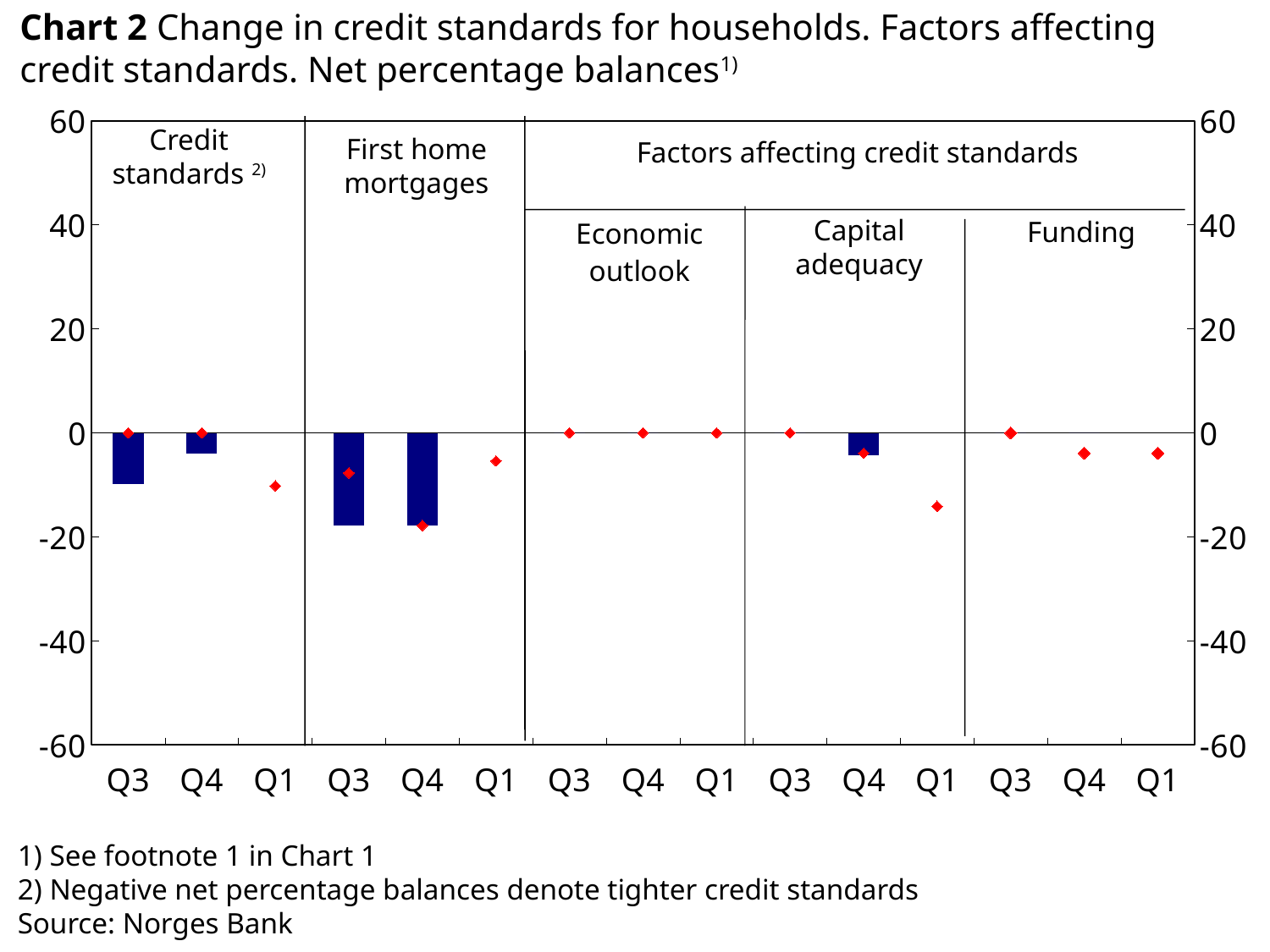
Do the values for Economic outlook rise, fall or stay flat from Q3 to Q1? stay flat What kind of chart is shown on the slide? bar chart with point markers Is the Q1 value for Funding greater or less than -20? greater What is the source given for the chart? Norges Bank Is the Q1 value for Capital adequacy greater or less than -10? less Is the value for Credit standards in Q4 greater or less than -20? greater Which is lower, the Q3 value for Credit standards or the Q3 value for First home mortgages? First home mortgages How many factors affecting credit standards are shown as separate panels in the chart? 3 How many quarter labels are shown along the x axis of the chart? 15 Which panel of the chart contains the lowest bar? First home mortgages